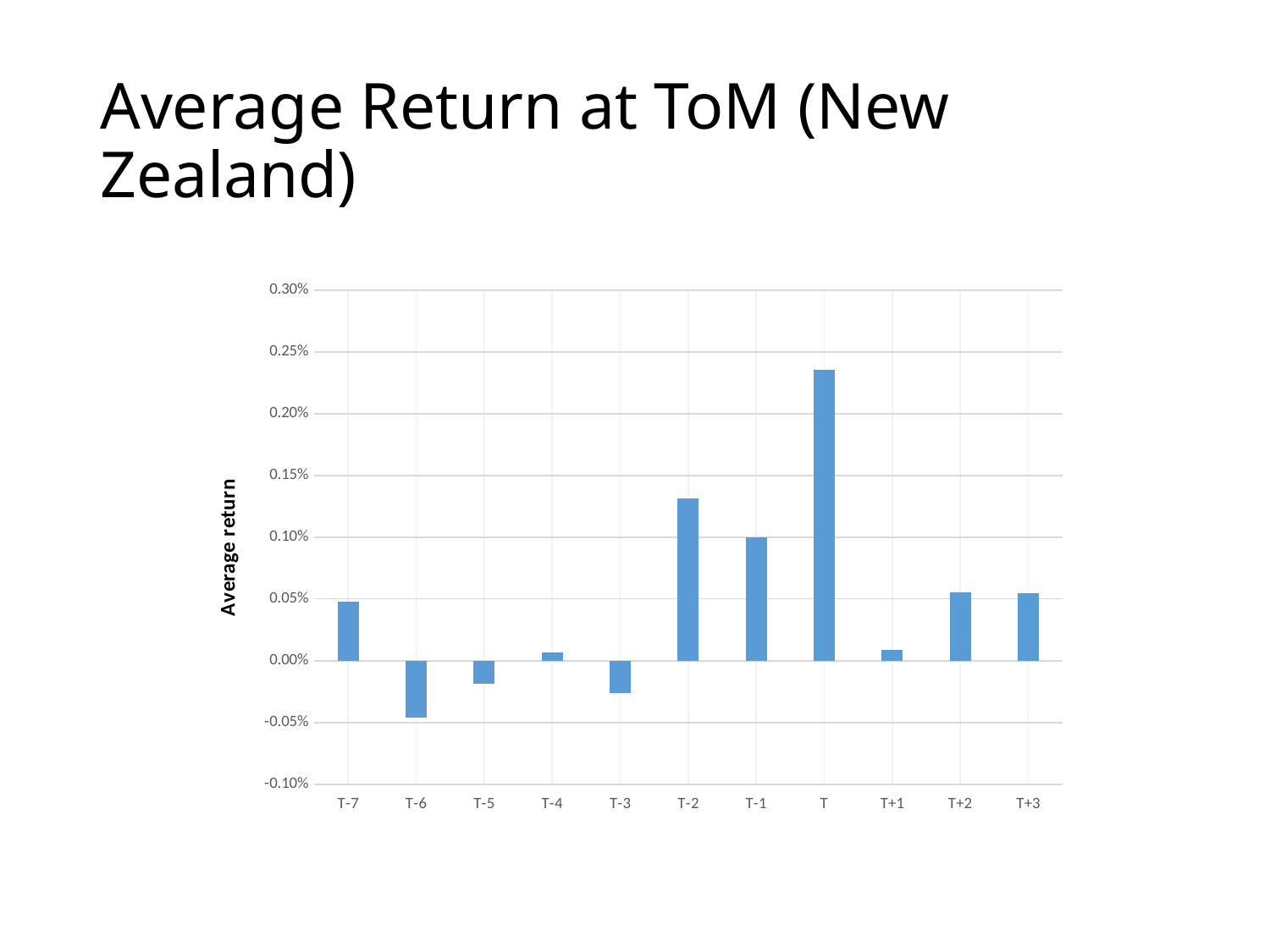
How many categories are plotted along the x axis? 11 Which is larger, the value for T-7 or the value for T+1? T-7 Which category has the lowest average return? T-6 What is the label on the vertical axis? Average return Is the value for T+2 greater or less than 0.10%? less Is the value for T-2 greater or less than 0.15%? less Which category has the highest average return? T Is the value for T greater or less than 0.20%? greater Which is larger, the value for T-2 or the value for T-1? T-2 What kind of chart is shown on the slide? bar chart Do the values rise or fall from T-3 to T? rise